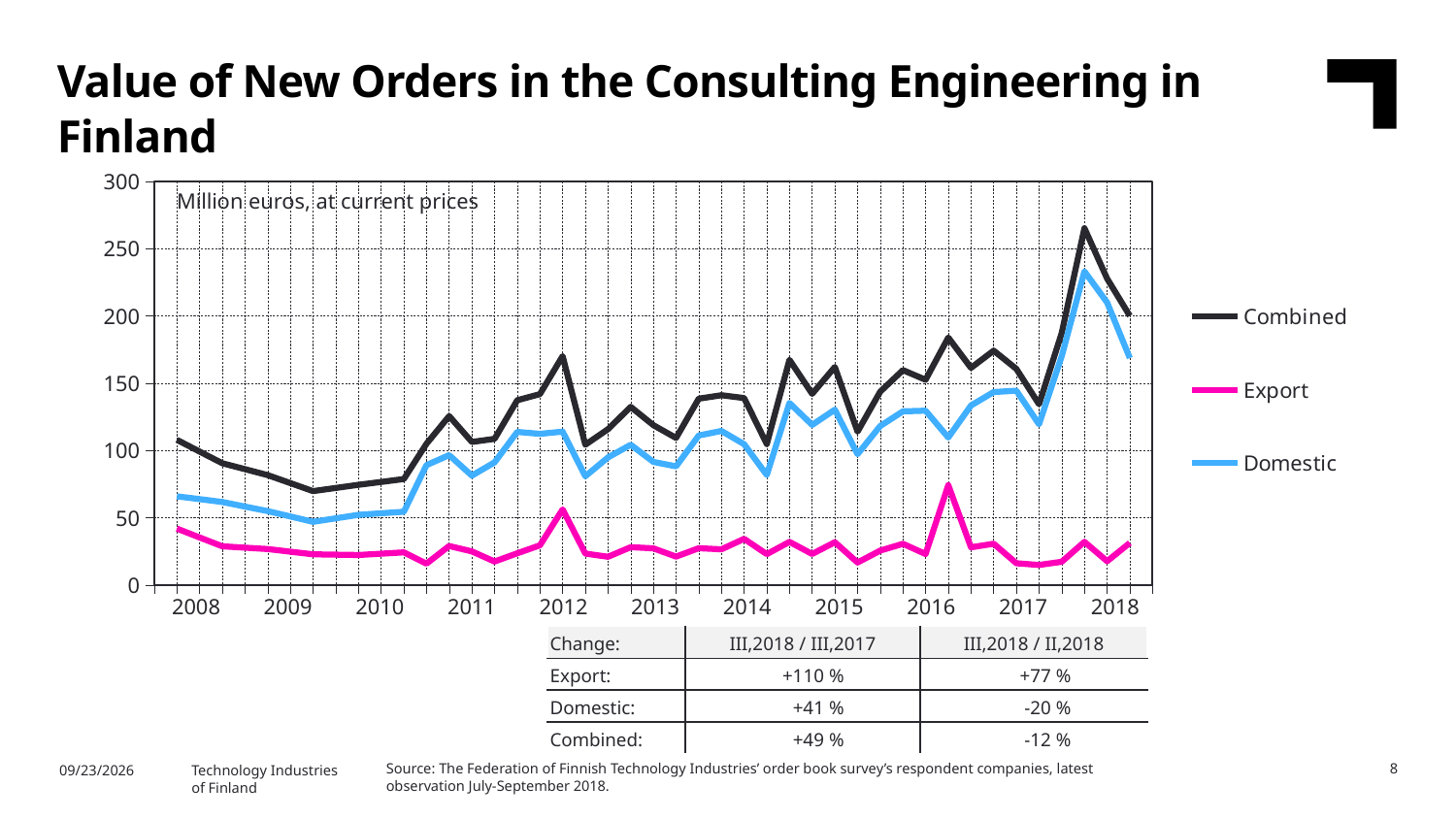
What unit is stated for the values in the chart? Million euros, at current prices Does the Export series rise or fall from 2008 to 2010? fall How many year labels are shown on the x axis? 11 Is the peak value of the Export series in 2016 greater or less than 50? greater Which is larger at the end of 2018, the Domestic value or the Export value? Domestic Which series is plotted with the lowest values throughout the chart? Export Is the Combined value at the start of 2008 greater or less than 100? greater Which series is plotted with the highest values throughout the chart? Combined How many series does the legend list? 3 What type of chart is shown on the slide? line chart